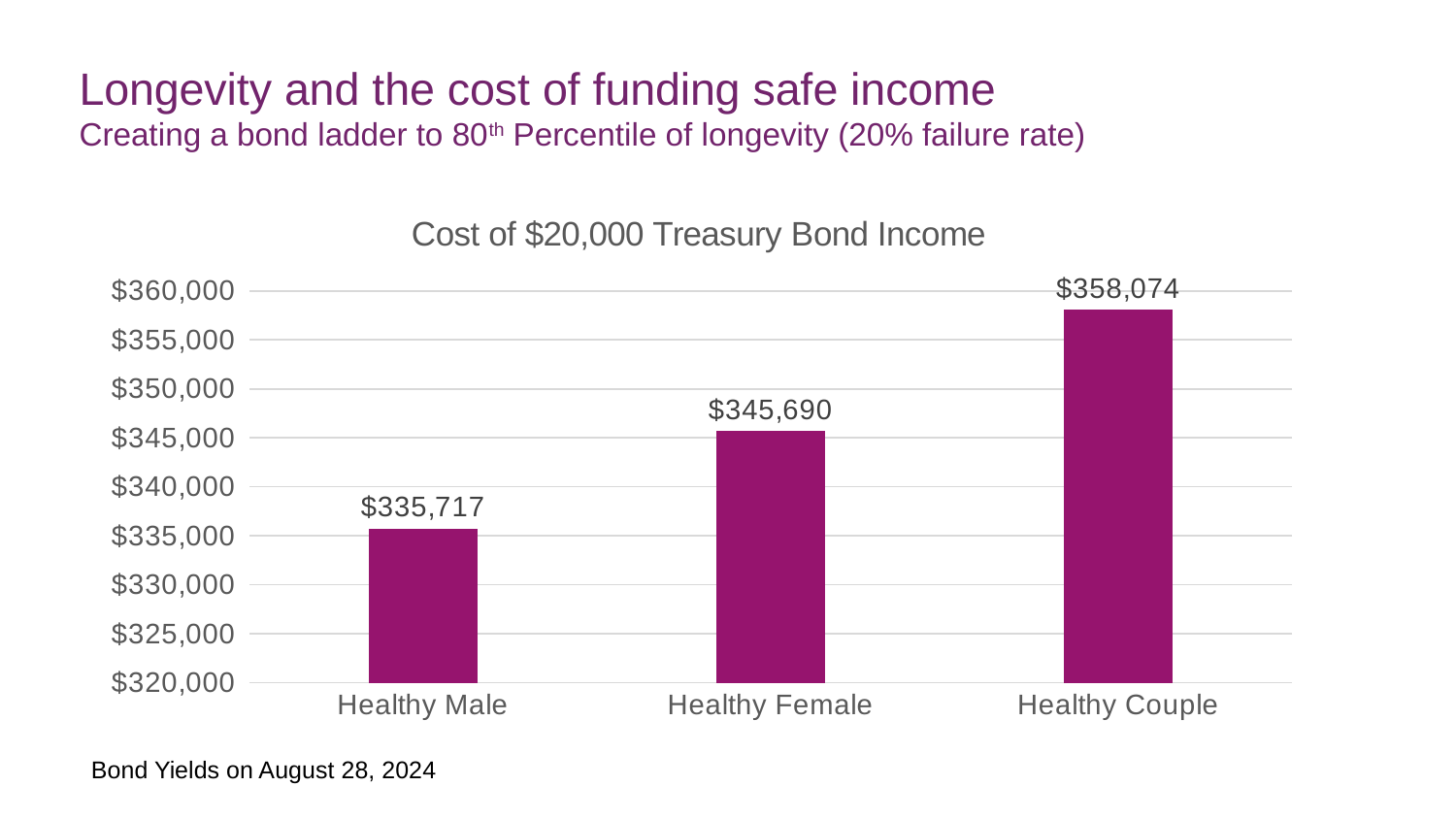
Is the value for Healthy Female greater or less than $340,000? greater Which category has the lowest cost? Healthy Male What is the difference in cost between Healthy Couple and Healthy Male? $22,357 What kind of chart is shown on the slide? Bar chart What is the difference in cost between Healthy Female and Healthy Male? $9,973 What is the cost of $20,000 Treasury Bond Income for a Healthy Couple? $358,074 How many categories are shown in the chart? 3 What is the title of the chart? Cost of $20,000 Treasury Bond Income Which has a higher cost, Healthy Female or Healthy Couple? Healthy Couple Which category has the highest cost? Healthy Couple What is the cost of $20,000 Treasury Bond Income for a Healthy Male? $335,717 What is the cost of $20,000 Treasury Bond Income for a Healthy Female? $345,690